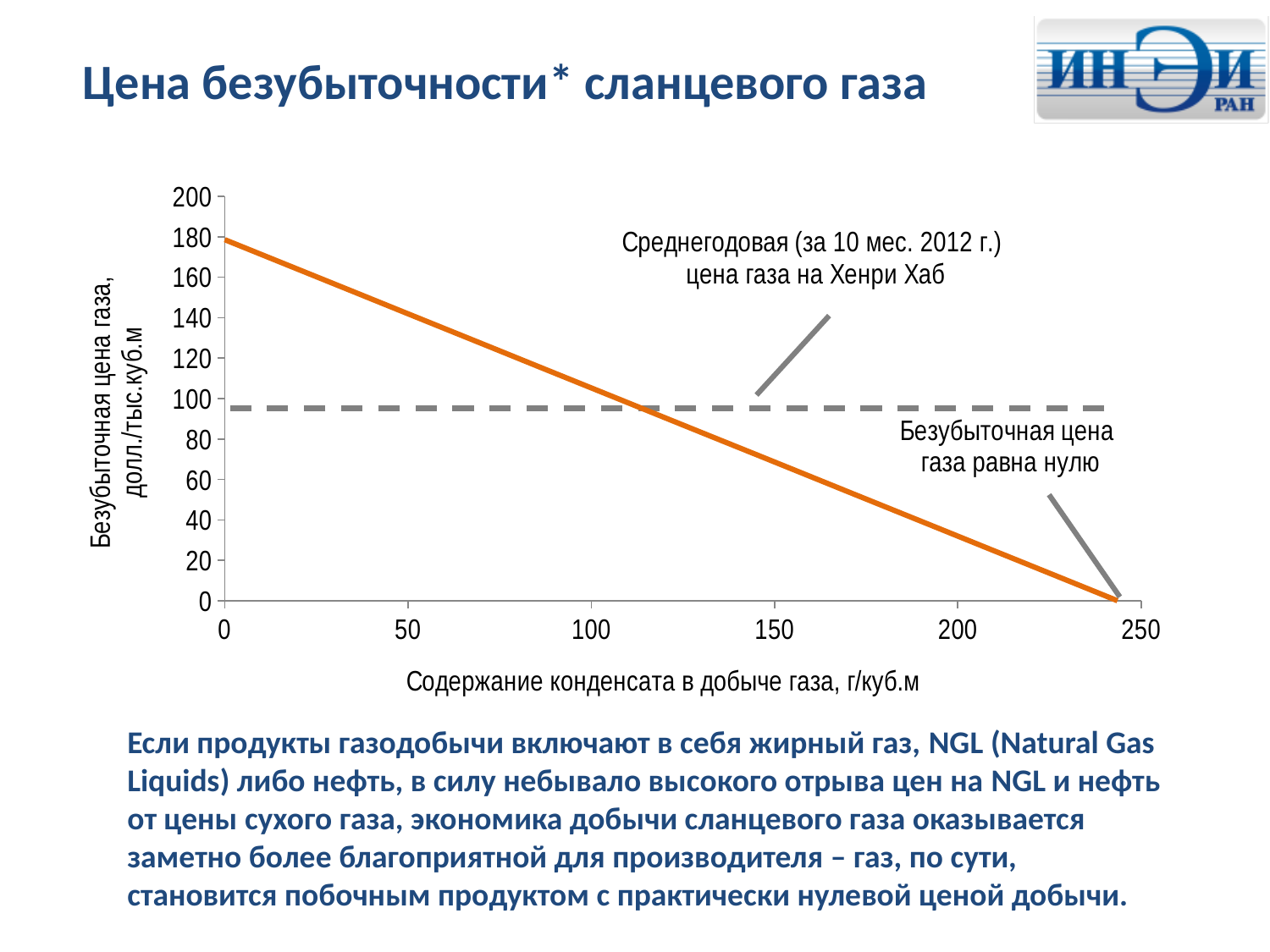
Is the breakeven gas price (orange line) at a condensate content of 200 g/cu.m greater or less than 40? less Does the orange line rise or fall as the condensate content increases along the x axis? falls Is the breakeven gas price (orange line) at a condensate content of 150 g/cu.m greater or less than 80? less At a condensate content of 200 g/cu.m, which is higher: the breakeven gas price (orange line) or the Henry Hub average price (dashed line)? Henry Hub average price (dashed line) Is the breakeven gas price (orange line) at a condensate content of 0 g/cu.m greater or less than 160? greater What is the label of the x axis of the chart? Содержание конденсата в добыче газа, г/куб.м What kind of chart is shown on the slide? line chart What does the dashed horizontal line on the chart represent, according to the annotation? Среднегодовая (за 10 мес. 2012 г.) цена газа на Хенри Хаб How many lines are plotted on the chart? 2 At a condensate content of 50 g/cu.m, which is higher: the breakeven gas price (orange line) or the Henry Hub average price (dashed line)? breakeven gas price (orange line)